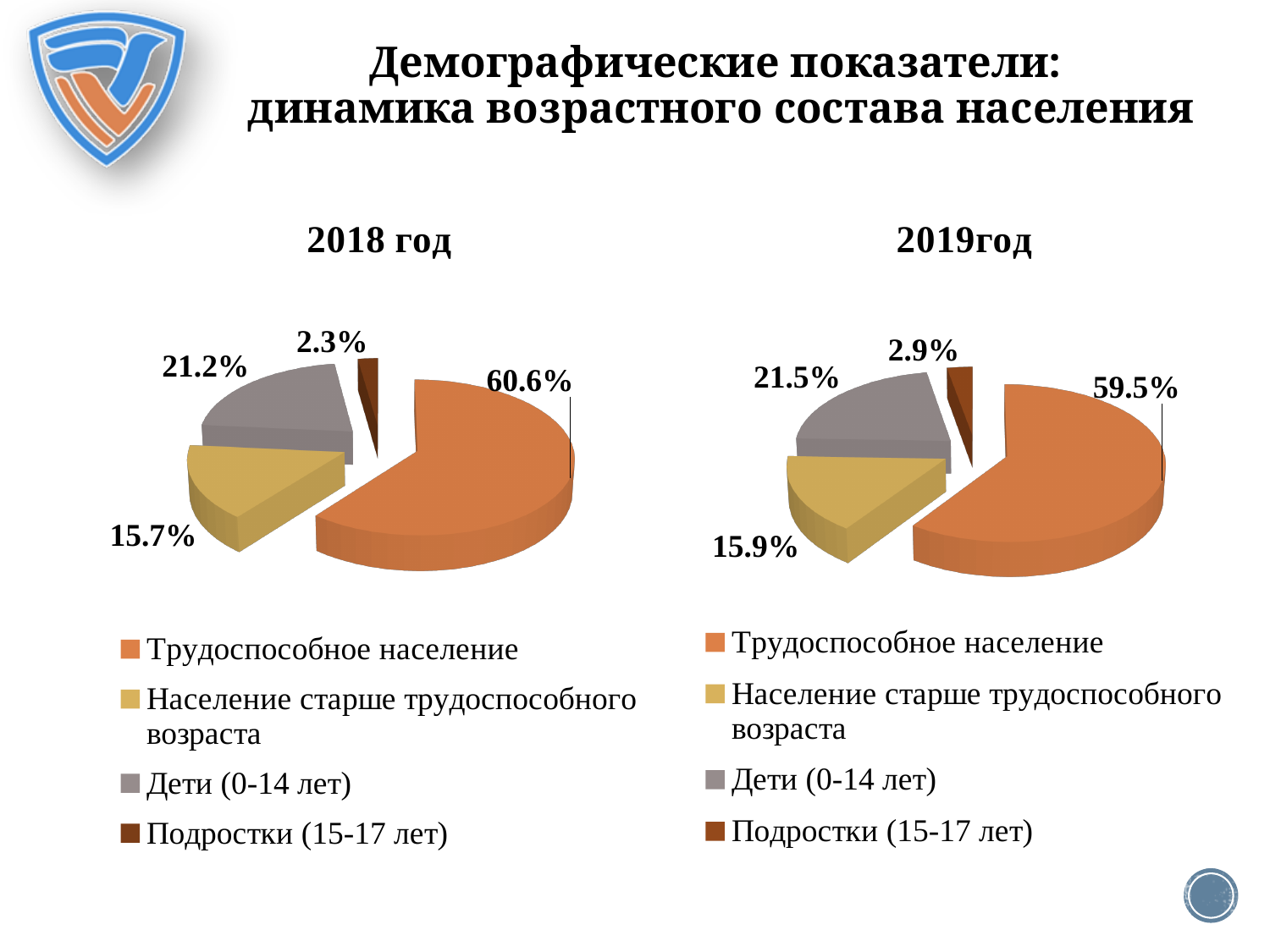
In the 2019год pie chart, what is the share for Дети (0-14 лет)? 21.5% In the 2019год pie chart, what is the difference between the shares of Дети (0-14 лет) and Население старше трудоспособного возраста? 5.6% What type of chart is used for the 2019год data? Pie chart What is the difference between the share of Трудоспособное население in the 2018 год chart and in the 2019год chart? 1.1% In the 2018 год pie chart, what is the share for Трудоспособное население? 60.6% In the 2018 год pie chart, what is the share for Подростки (15-17 лет)? 2.3% How many categories does the 2018 год pie chart show? 4 In the 2019год pie chart, what is the share for Население старше трудоспособного возраста? 15.9% In the 2019год pie chart, which category has the smallest share? Подростки (15-17 лет) In the 2018 год pie chart, which colour represents Подростки (15-17 лет)? Dark brown Which is larger: the share of Дети (0-14 лет) in the 2018 год chart or in the 2019год chart? 2019год In the 2018 год pie chart, which category has the largest share? Трудоспособное население